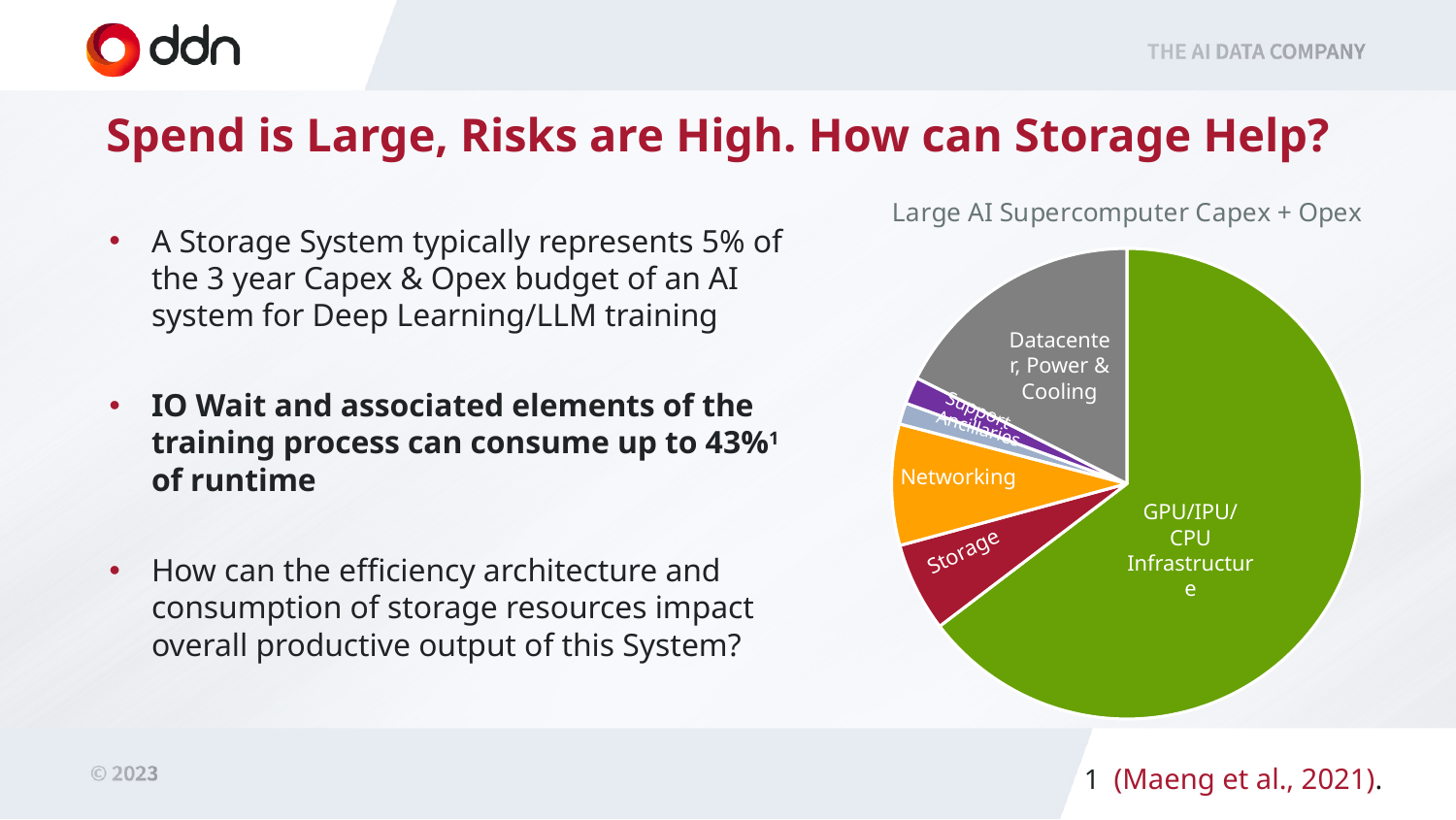
Which slice is larger in the pie chart: GPU/IPU/CPU Infrastructure or Storage? GPU/IPU/CPU Infrastructure Which slice is larger in the pie chart: Datacenter, Power & Cooling or Storage? Datacenter, Power & Cooling What is the title of the pie chart? Large AI Supercomputer Capex + Opex Which slice is larger in the pie chart: Datacenter, Power & Cooling or Networking? Datacenter, Power & Cooling How many slices does the pie chart have? 6 Which category has the largest slice in the pie chart? GPU/IPU/CPU Infrastructure What colour is the GPU/IPU/CPU Infrastructure slice in the pie chart? Green What kind of chart is shown on the slide? Pie chart